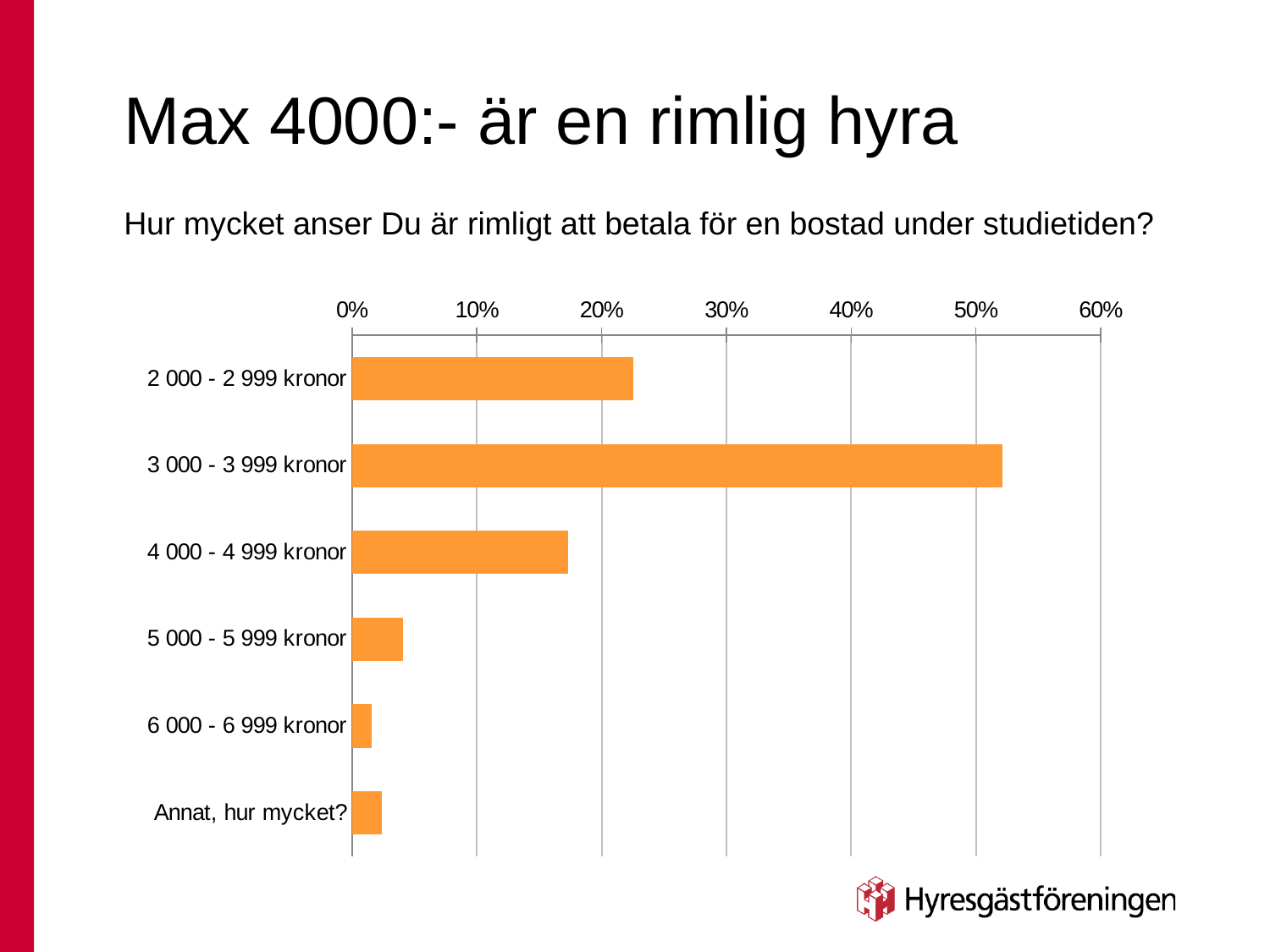
How many categories are shown in the chart? 6 Is the value for 3 000 - 3 999 kronor greater or less than 50%? greater What is the highest value shown on the horizontal axis? 60% Which category has the lowest value? 6 000 - 6 999 kronor What question is the chart based on, as written above it? Hur mycket anser Du är rimligt att betala för en bostad under studietiden? Which is larger, the value for 2 000 - 2 999 kronor or the value for 4 000 - 4 999 kronor? 2 000 - 2 999 kronor Is the value for 4 000 - 4 999 kronor greater or less than 20%? less Is the value for 5 000 - 5 999 kronor greater or less than 10%? less Which category has the highest value? 3 000 - 3 999 kronor Which is larger, the value for 5 000 - 5 999 kronor or the value for Annat, hur mycket? 5 000 - 5 999 kronor What kind of chart is shown on the slide? bar chart